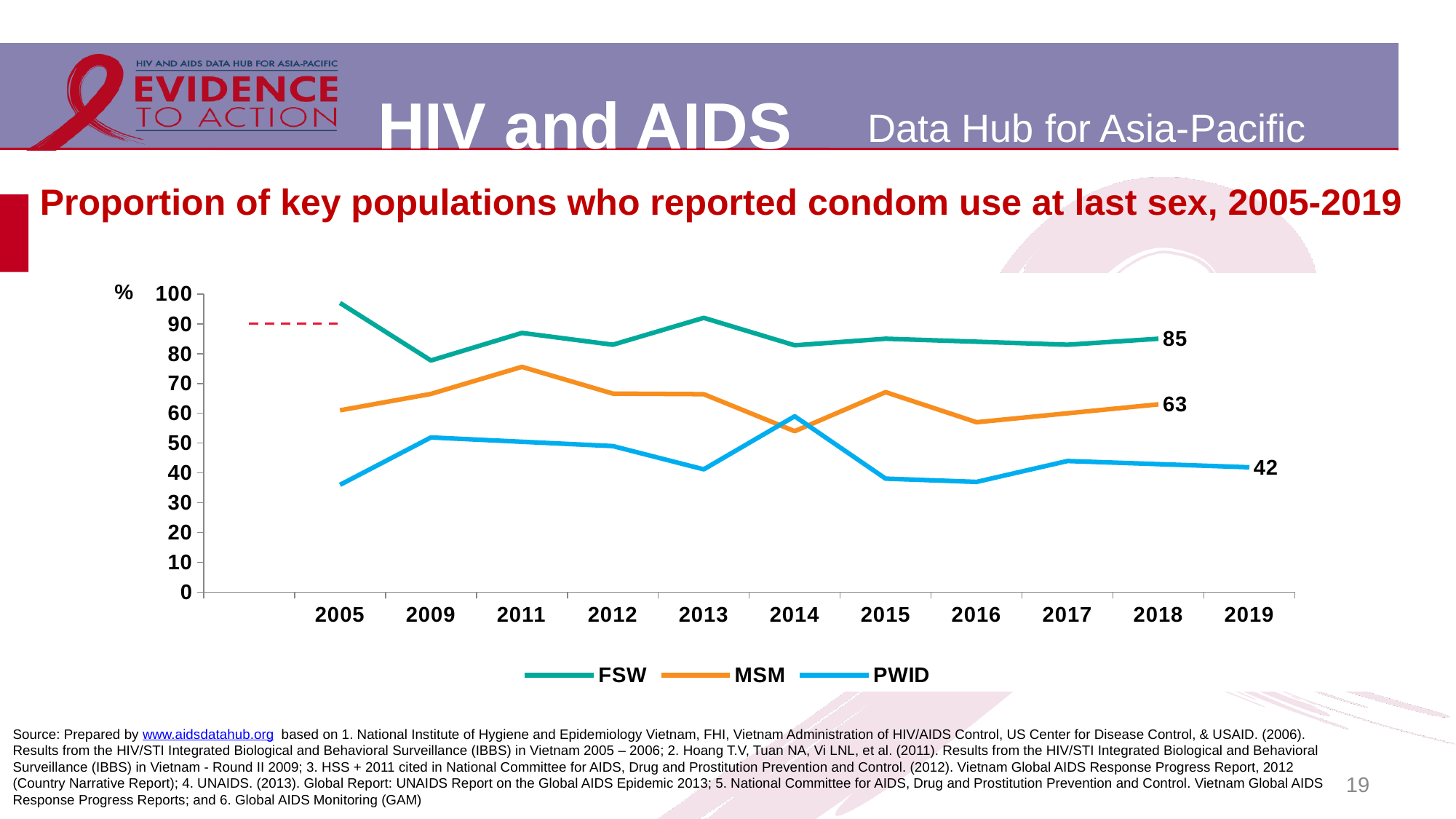
What is the labelled value for PWID in 2019? 42 Is the value for PWID in 2005 greater or less than 40? less How many years are shown on the x axis? 11 What is the last labelled value on the FSW line? 85 Which series has the highest labelled value at the end of the chart? FSW How many series does the legend list? 3 Is the value for FSW in 2005 greater or less than 90? greater In 2005, which is larger, the FSW value or the PWID value? FSW What is the last labelled value on the MSM line? 63 What kind of chart is shown on the slide? line chart Does the FSW line rise or fall between 2005 and 2009? fall What is the difference between the last labelled FSW value (85) and the last labelled MSM value (63)? 22